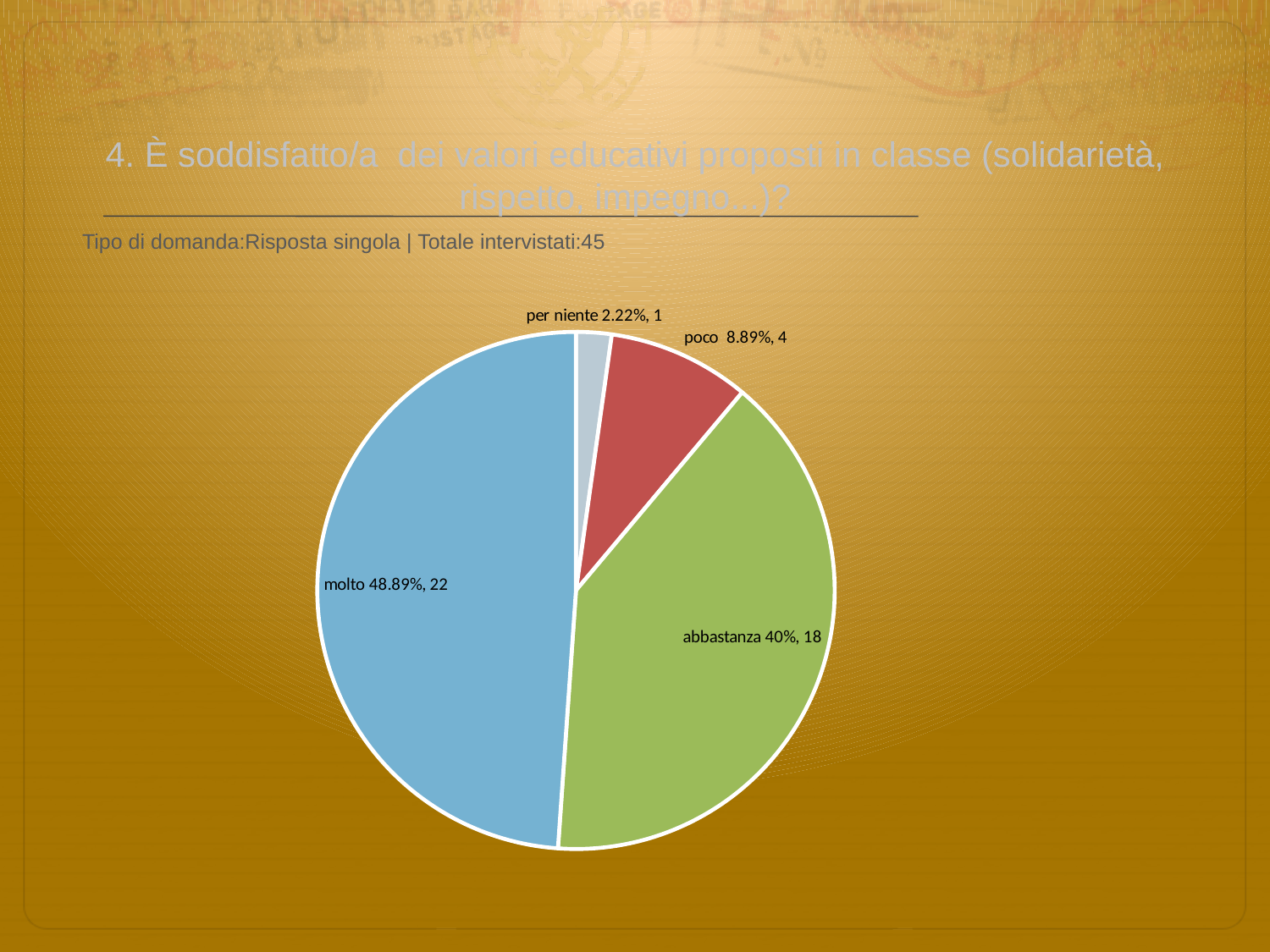
What percentage share does the 'per niente' slice have? 2.22% What is the total number of respondents shown on the slide? 45 How many respondents answered 'abbastanza'? 18 What percentage share does the 'molto' slice have? 48.89% What kind of chart is shown on the slide? pie chart How many respondents answered 'poco'? 4 Which category has the smallest slice? per niente What is the difference in respondent count between 'molto' and 'abbastanza'? 4 Which has more respondents, 'poco' or 'per niente'? poco Which category has the largest slice? molto How many slices does the pie chart have? 4 What colour is the 'abbastanza' slice? green